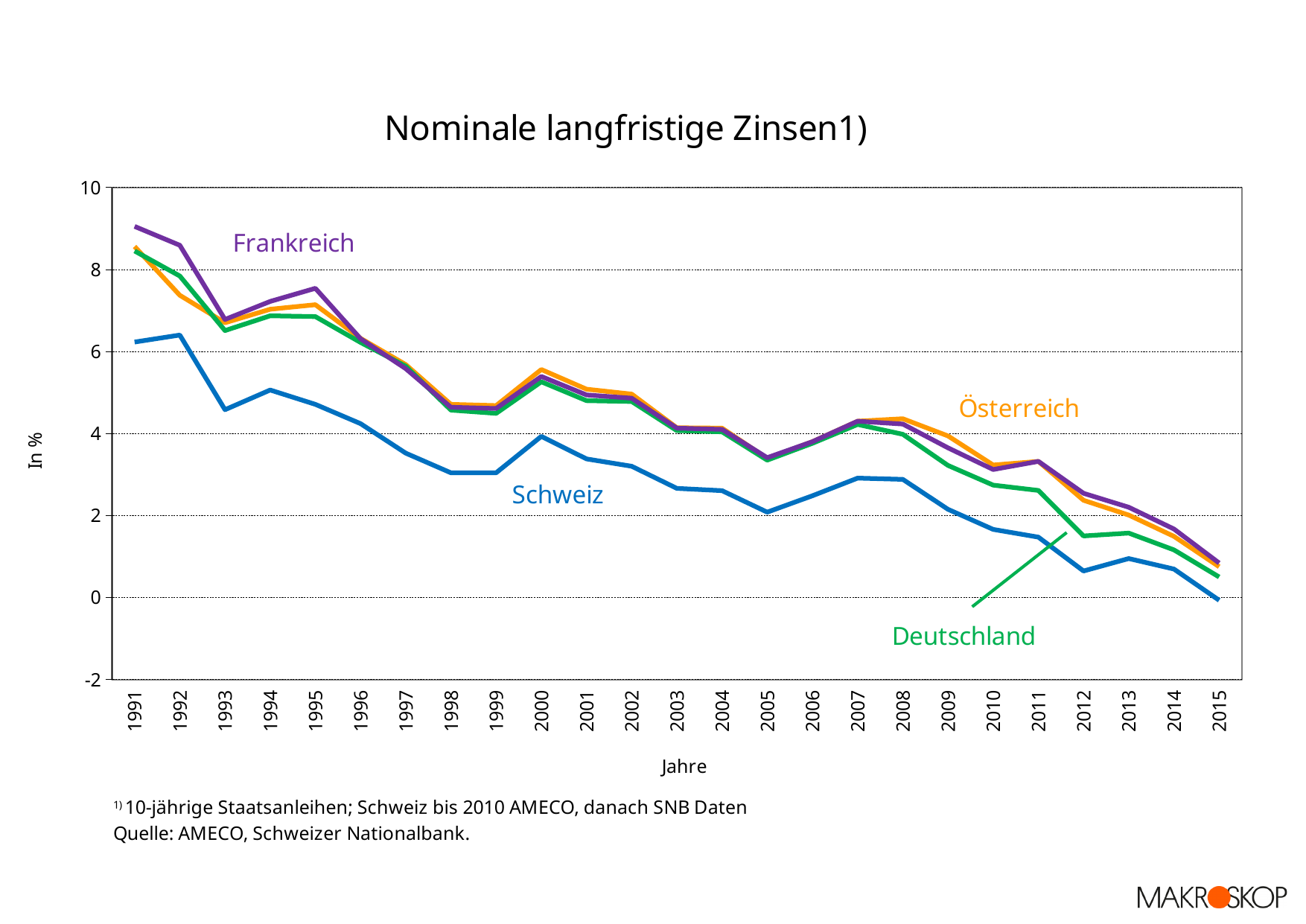
Is the value for Deutschland in 2012 greater or less than 2? less What kind of chart is shown on the slide? line chart What is the label of the y axis? In % How many years are shown on the x axis of the chart? 25 Which country has the highest value in 1991? Frankreich How many series (countries) are plotted in the chart? 4 What is the title of the chart? Nominale langfristige Zinsen1) Is the value for Frankreich in 1991 greater or less than 8? greater In 1991, which is larger: the value for Schweiz or the value for Frankreich? Frankreich Which country has the lowest value in 2015? Schweiz Do the interest rates generally rise or fall from 1991 to 2015? fall Is the value for Schweiz in 2012 greater or less than 2? less